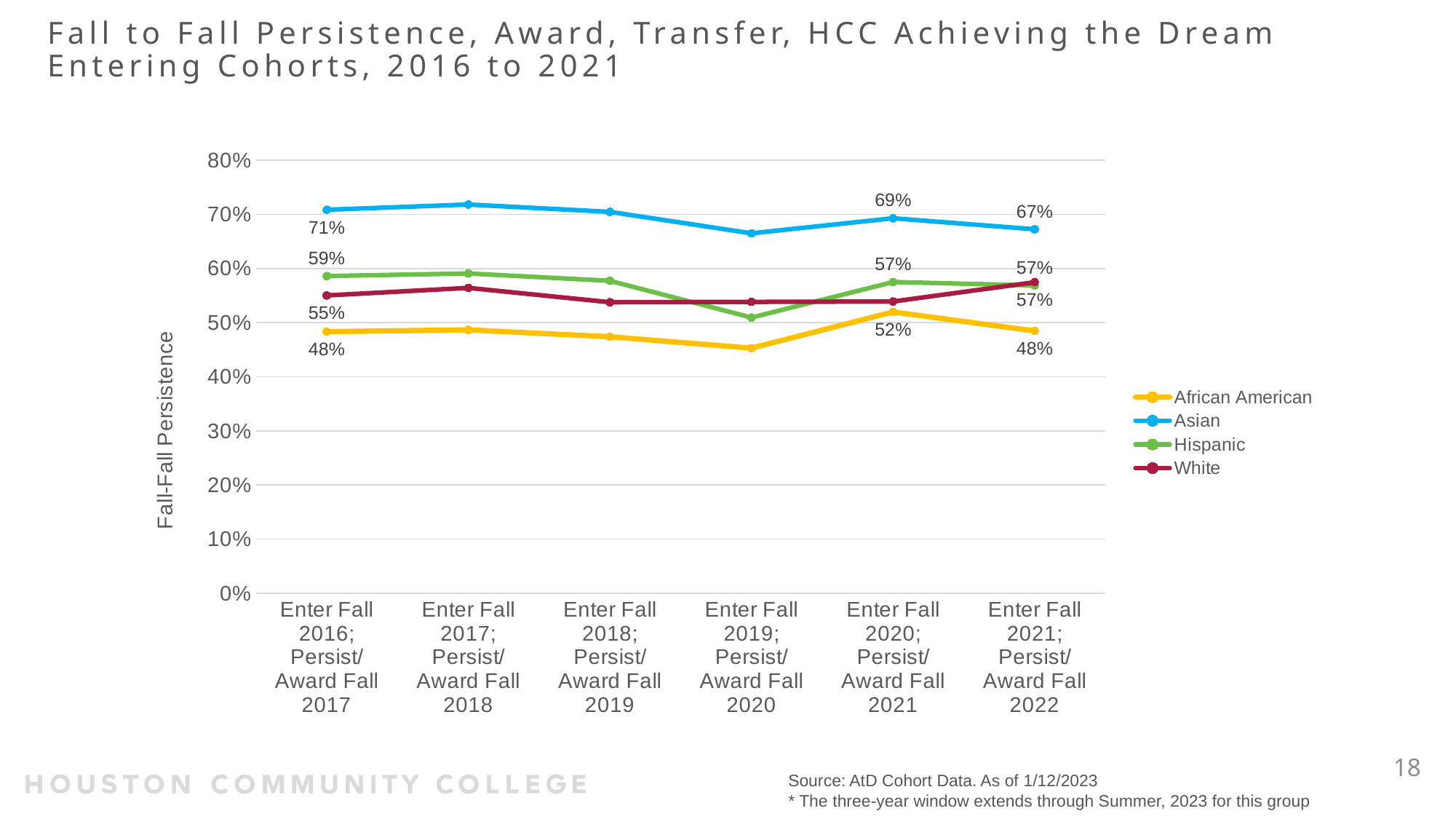
How many entering cohorts are shown on the x axis? 6 What is the difference between the Asian and African American values in the Enter Fall 2016 cohort? 23 percentage points Which group has the highest persistence in the Enter Fall 2016 cohort? Asian Is the Asian value higher in the Enter Fall 2020 cohort or the Enter Fall 2021 cohort? Enter Fall 2020 Which group has the lowest persistence in the Enter Fall 2021 cohort? African American What is the Fall-Fall Persistence value for Asian students in the Enter Fall 2016 cohort? 71% What kind of chart is shown on the slide? line chart How many series does the legend list? 4 What is the value for Hispanic students in the Enter Fall 2016 cohort? 59% What is the value for African American students in the Enter Fall 2020 cohort? 52% What is the value for White students in the Enter Fall 2016 cohort? 55% Is the value for Asian students in the Enter Fall 2019 cohort greater or less than 60%? greater